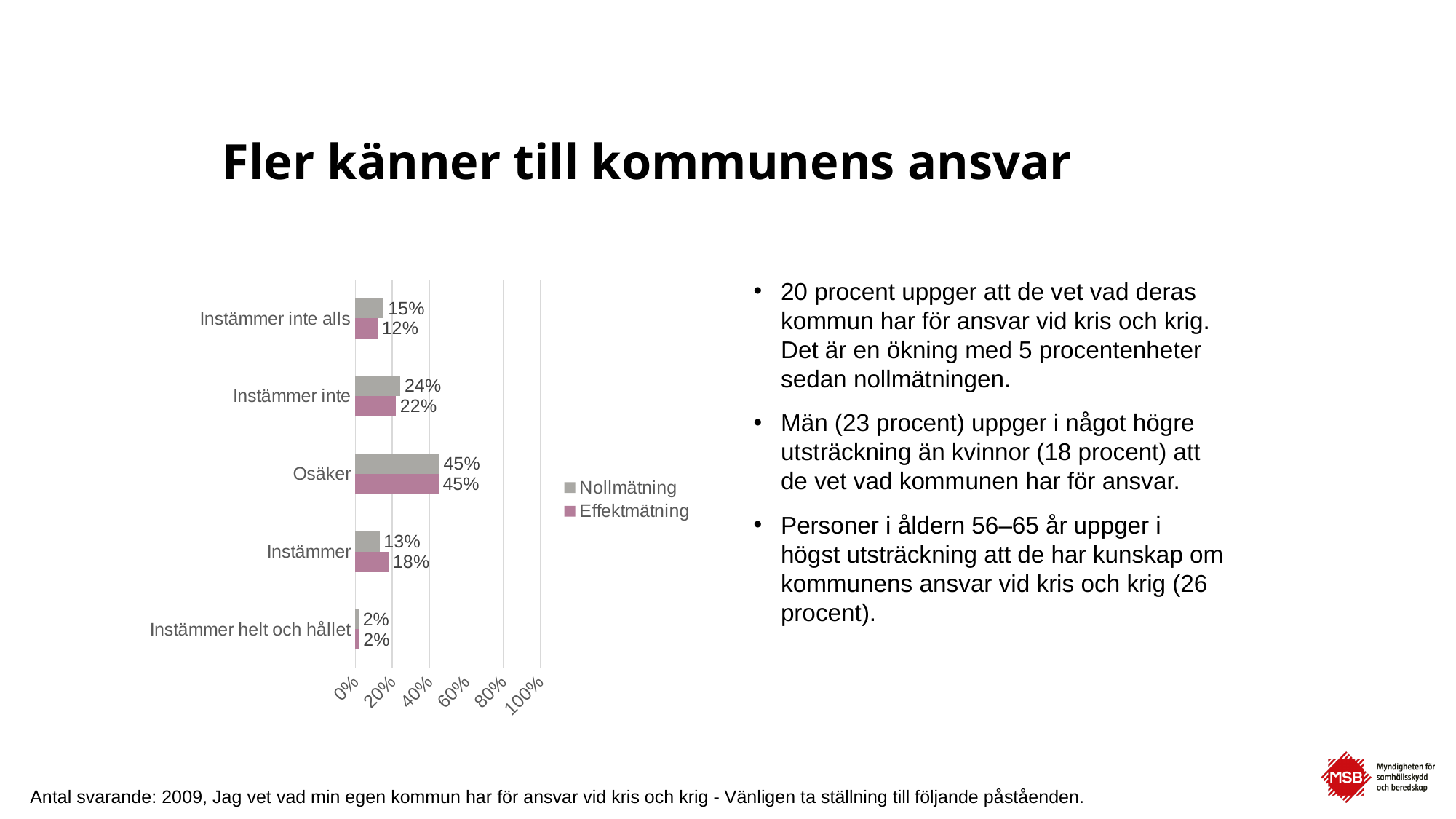
What kind of chart is shown on the slide? Bar chart How many series does the legend list? 2 For Instämmer inte alls, which series has the larger value, Nollmätning or Effektmätning? Nollmätning Which category has the lowest Nollmätning value? Instämmer helt och hållet What is the difference between the Effektmätning and Nollmätning values for Instämmer? 5% What is the Effektmätning value for Instämmer inte? 22% Which series is shown in pink/purple in the legend? Effektmätning What is the Effektmätning value for Instämmer? 18% Which category has the highest Effektmätning value? Osäker What is the Nollmätning value for Instämmer inte alls? 15% Is the Nollmätning value for Osäker greater or less than 40%? greater How many categories are shown on the chart? 5